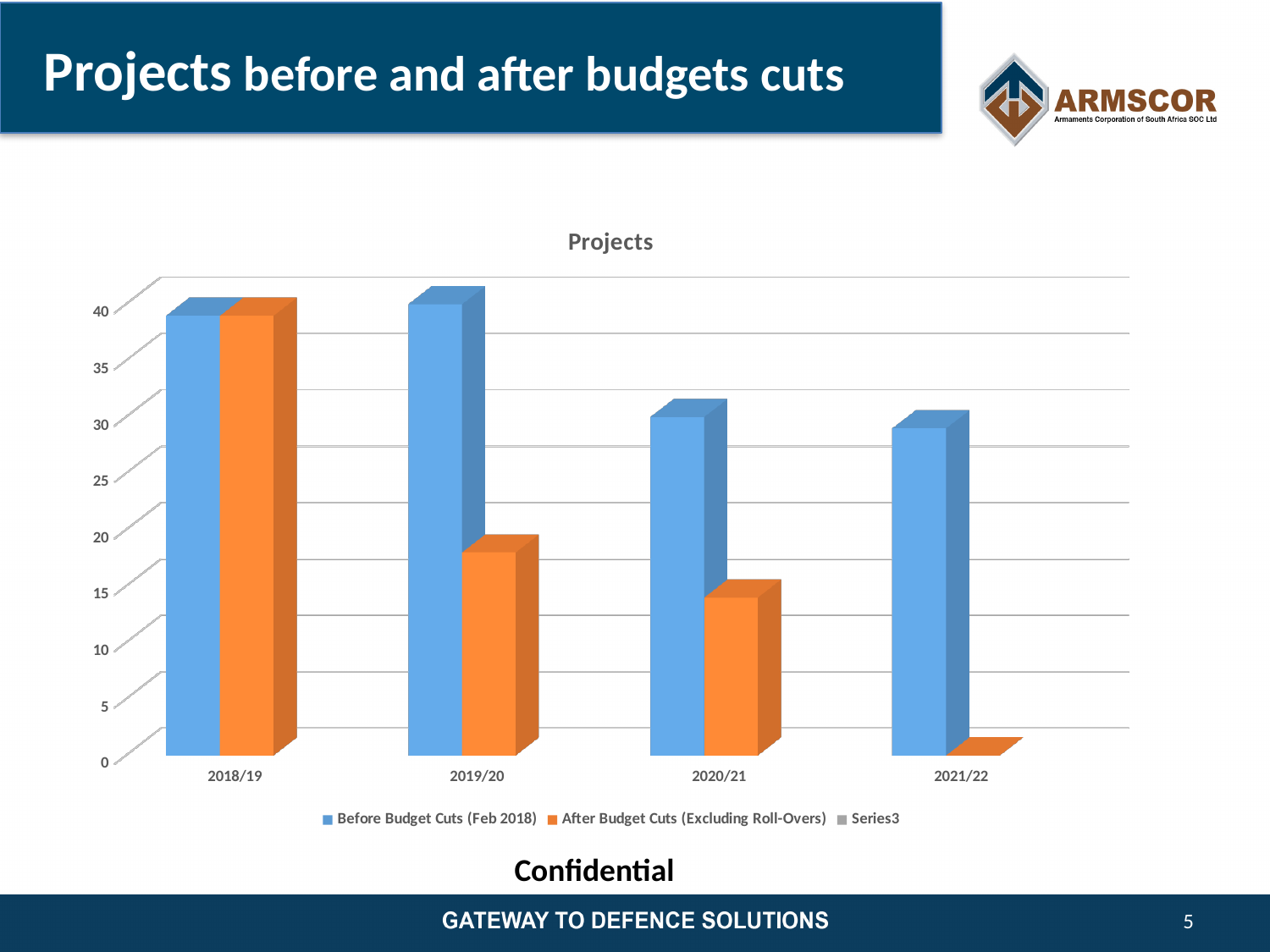
For 2019/20, which is larger: Before Budget Cuts (Feb 2018) or After Budget Cuts (Excluding Roll-Overs)? Before Budget Cuts (Feb 2018) How many series does the legend list? 3 Is the value for Before Budget Cuts (Feb 2018) in 2021/22 greater or less than 20? greater Is the value for After Budget Cuts (Excluding Roll-Overs) in 2020/21 greater or less than 20? less Do the values for After Budget Cuts (Excluding Roll-Overs) rise or fall from 2018/19 to 2021/22? fall Which category has the highest value for After Budget Cuts (Excluding Roll-Overs)? 2018/19 What kind of chart is shown on the slide? Bar chart Which colour represents the Before Budget Cuts (Feb 2018) series? Blue Is the value for Before Budget Cuts (Feb 2018) in 2018/19 greater or less than 30? greater What is the title of the chart? Projects How many financial year categories are shown on the x axis? 4 Which category has the lowest value for After Budget Cuts (Excluding Roll-Overs)? 2021/22